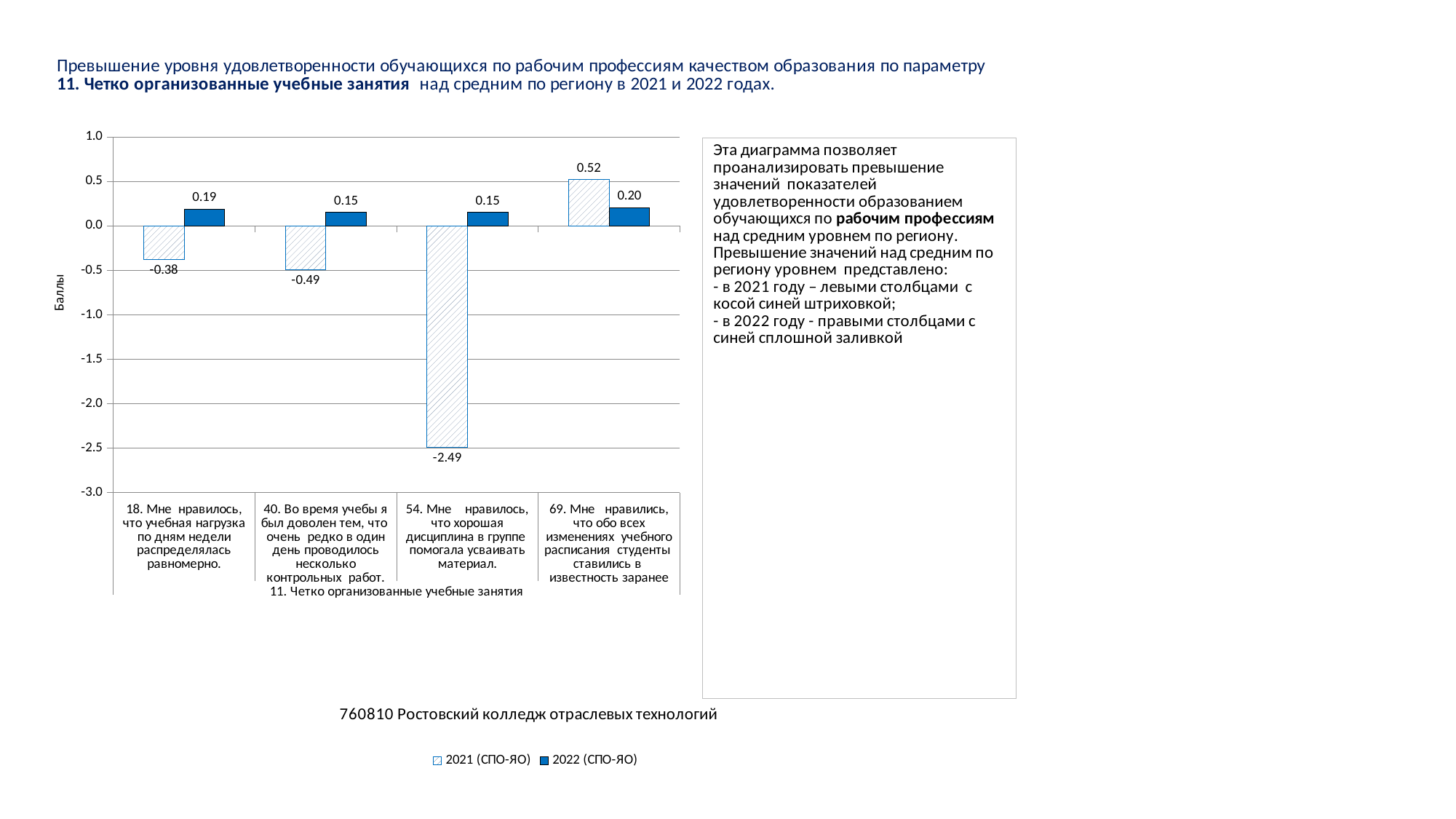
How many categories are shown on the x axis of the chart? 4 Which category has the highest value in the 2022 (СПО-ЯО) series? 69. Мне нравились, что обо всех изменениях учебного расписания студенты ставились в известность заранее What is the value of the 2021 (СПО-ЯО) series for category 54 ("Мне нравилось, что хорошая дисциплина в группе помогала усваивать материал")? -2.49 Which category has the lowest value in the 2021 (СПО-ЯО) series? 54. Мне нравилось, что хорошая дисциплина в группе помогала усваивать материал. What is the value of the 2021 (СПО-ЯО) series for category 18 ("Мне нравилось, что учебная нагрузка по дням недели распределялась равномерно")? -0.38 What is the label of the vertical axis of the chart? Баллы For category 69, which series has the larger value: 2021 (СПО-ЯО) or 2022 (СПО-ЯО)? 2021 (СПО-ЯО) Is the 2021 (СПО-ЯО) value for category 54 greater or less than -2.0? less What type of chart is shown on the slide? bar chart What is the value of the 2022 (СПО-ЯО) series for category 69 ("Мне нравились, что обо всех изменениях учебного расписания студенты ставились в известность заранее")? 0.20 What is the difference between the 2022 (СПО-ЯО) and 2021 (СПО-ЯО) values for category 40 ("Во время учебы я был доволен тем, что очень редко в один день проводилось несколько контрольных работ")? 0.64 How many series does the chart legend list? 2